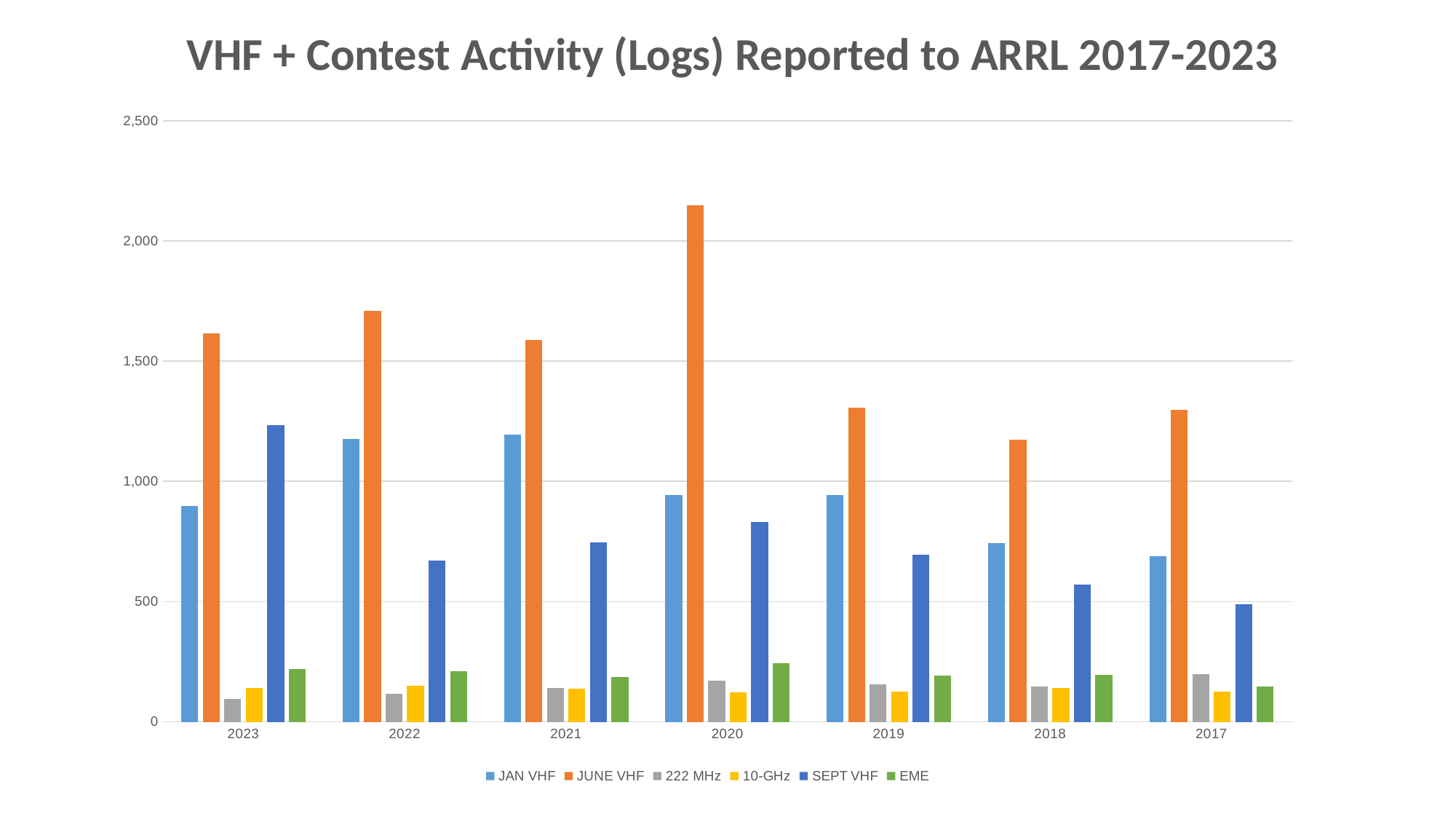
What is the title of the chart? VHF + Contest Activity (Logs) Reported to ARRL 2017-2023 How many series does the legend list? 6 Which is larger, the SEPT VHF value for 2023 or for 2022? 2023 Moving left to right along the x axis from 2020 to 2017, does the SEPT VHF value rise or fall? fall Which series has the highest value in 2023? JUNE VHF In which year is the SEPT VHF value lowest? 2017 Is the JUNE VHF value for 2020 greater or less than 2,000? greater What kind of chart is shown on the slide? bar chart In which year is the JUNE VHF value highest? 2020 Is the JAN VHF value for 2023 greater or less than 1,000? less How many years are shown along the x axis? 7 Is the SEPT VHF value for 2023 greater or less than 1,000? greater